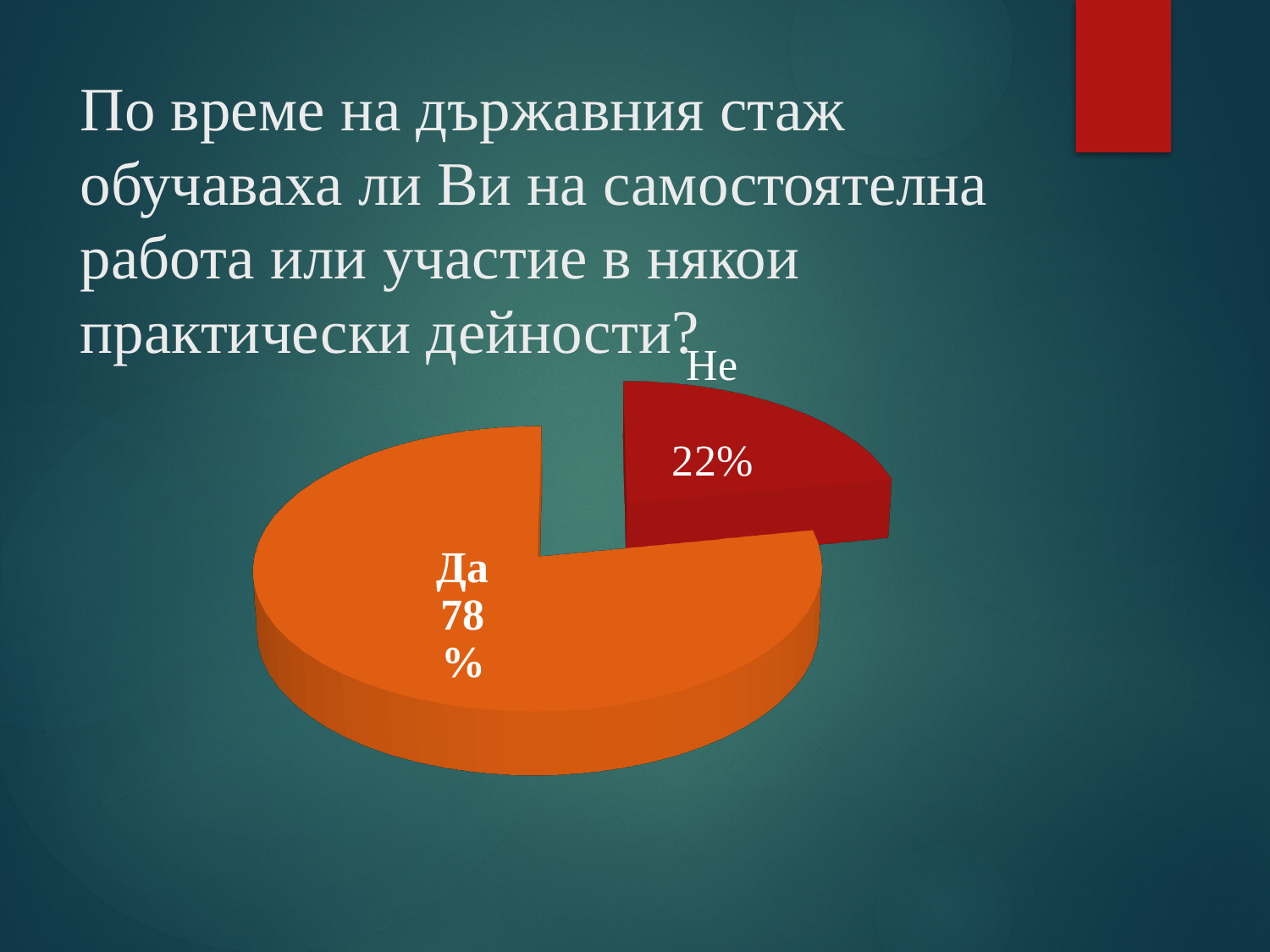
What kind of chart is shown on the slide? pie chart What colour is the "Не" slice of the pie? red What share of the pie does the "Да" slice represent? 78% What colour is the "Да" slice of the pie? orange What share of the pie does the "Не" slice represent? 22% Which slice of the pie is the largest? Да Which slice of the pie is the smallest? Не What is the difference in percentage points between the "Да" and "Не" slices? 56 What is the total of the two slice percentages shown on the pie chart? 100% How many slices does the pie chart have? 2 Which is larger, the "Да" slice or the "Не" slice? Да